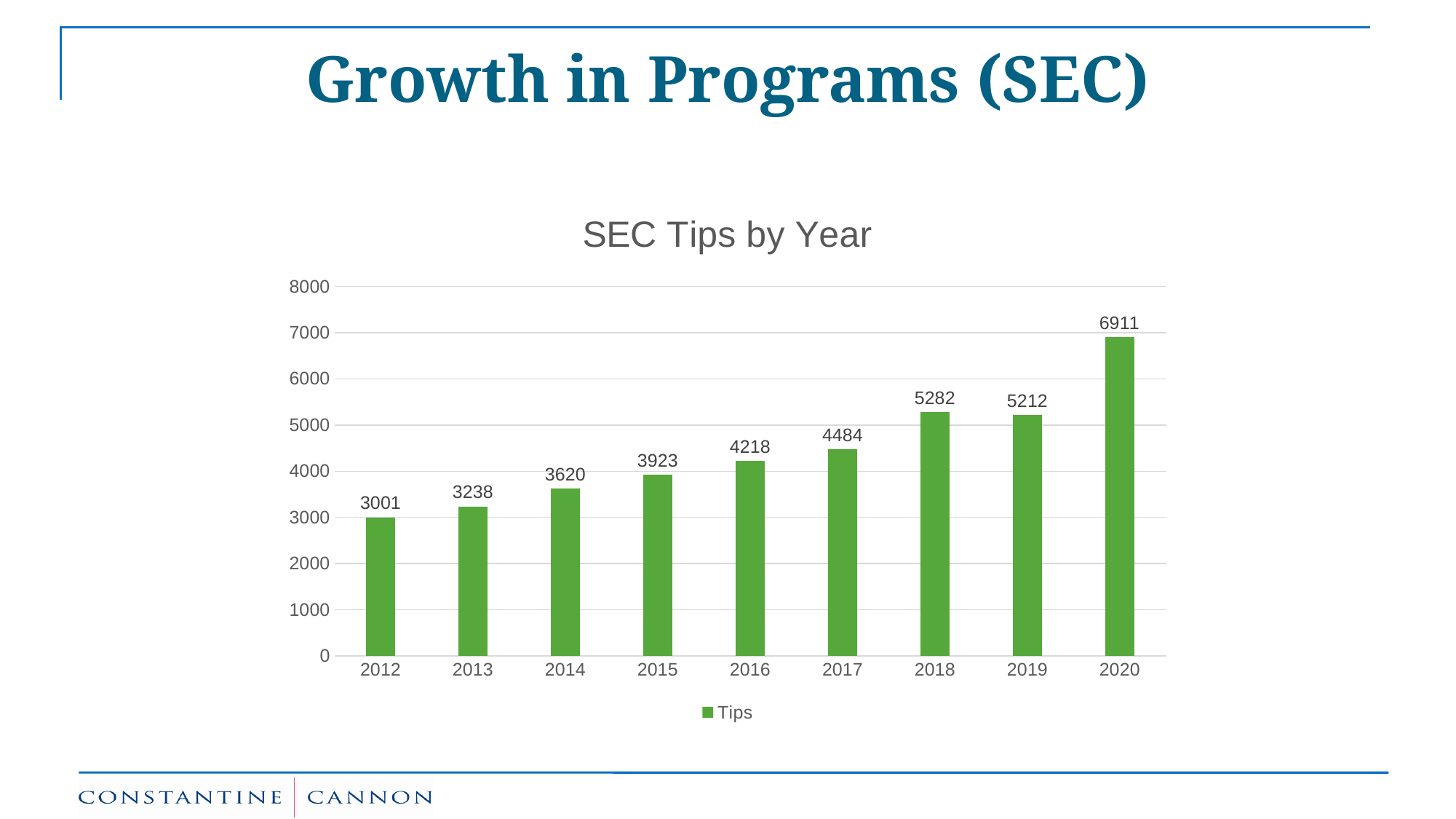
Which year has the highest number of Tips? 2020 Do the Tips values generally rise or fall from 2012 to 2020? rise What kind of chart is shown on the slide? bar chart How many years are shown on the x axis? 9 What is the value of Tips for 2012? 3001 Is the value for 2017 greater or less than 4000? greater What is the title of the chart? SEC Tips by Year Which year has more Tips, 2018 or 2019? 2018 How many series does the legend list? 1 Which year has the lowest number of Tips? 2012 What is the value of Tips for 2016? 4218 What is the difference in Tips between 2020 and 2019? 1699